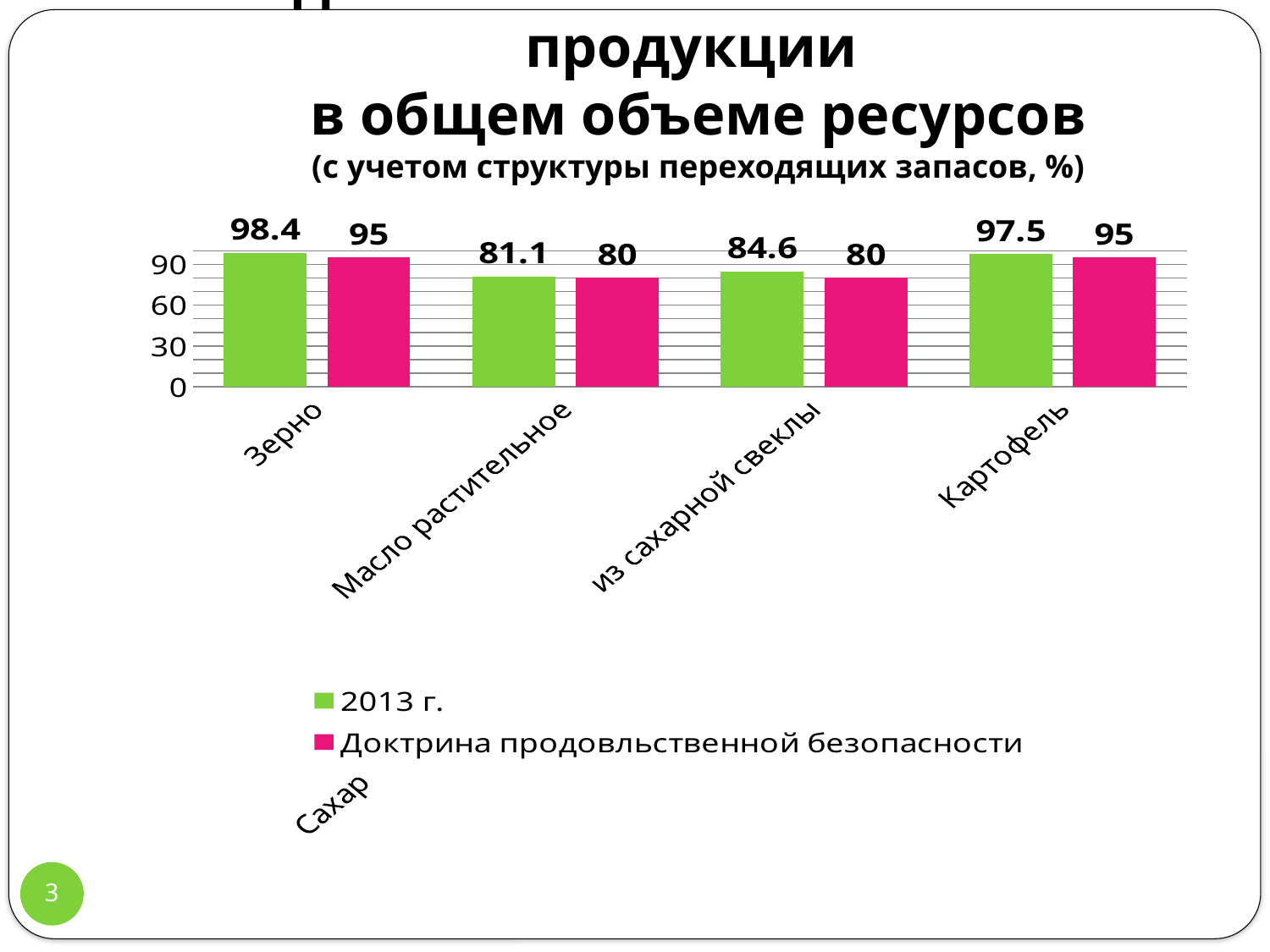
What is the difference between the 2013 г. value and the Доктрина продовльственной безопасности value for Зерно? 3.4 Which is larger for Картофель: the 2013 г. value or the Доктрина продовльственной безопасности value? 2013 г. What colour are the bars for the 2013 г. series? Green How many categories are shown on the x axis of the chart? 4 What is the 2013 г. value for Картофель? 97.5 What is the value for Зерно in the 2013 г. series? 98.4 Which category has the lowest value in the 2013 г. series? Масло растительное What is the 2013 г. value for the category labelled из сахарной свеклы? 84.6 Which category has the highest value in the 2013 г. series? Зерно How many series does the legend list? 2 What kind of chart is shown on the slide? Bar chart What is the value for Масло растительное in the Доктрина продовольственной безопасности series? 80